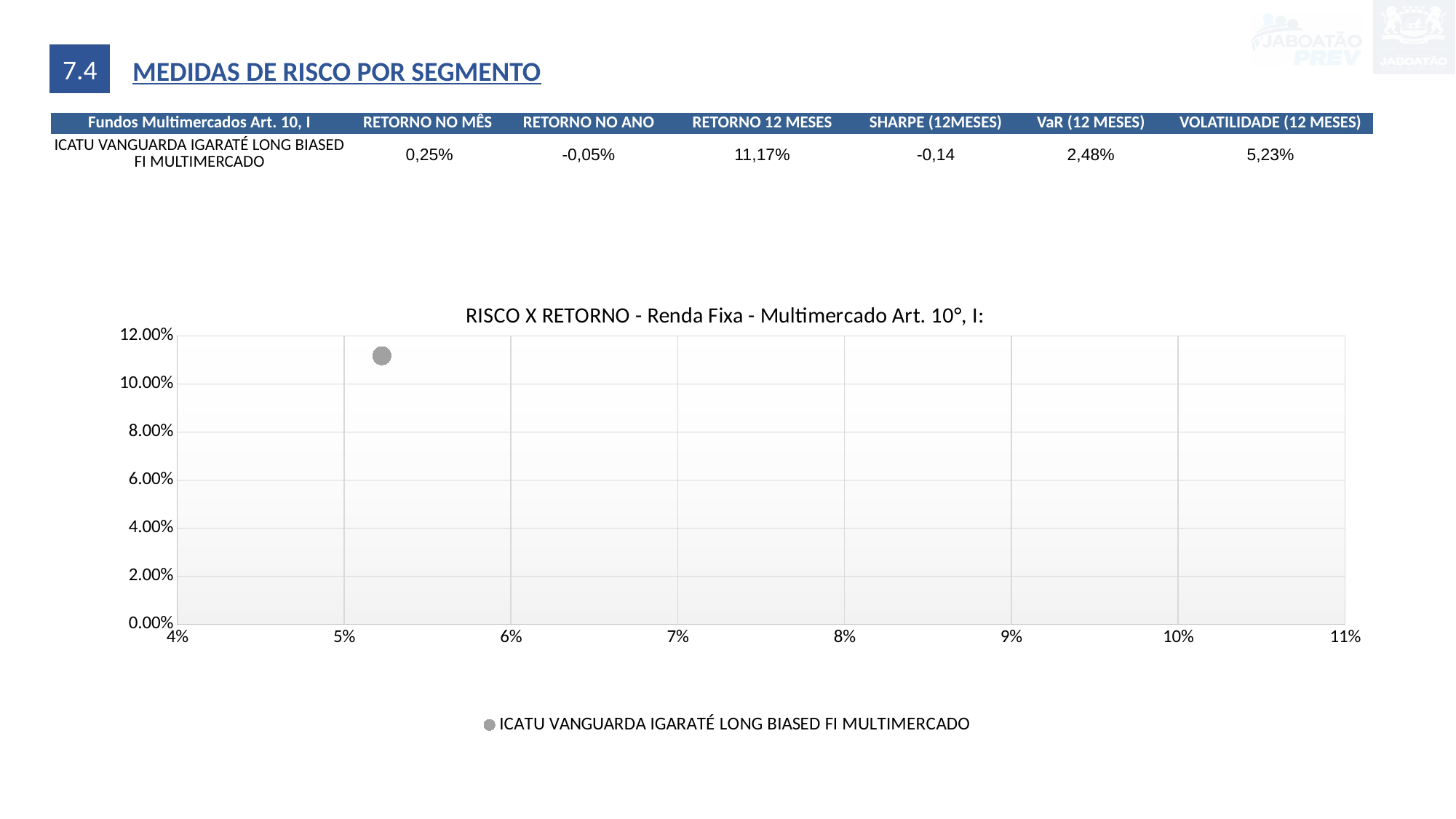
What is the title of the chart on the slide? RISCO X RETORNO - Renda Fixa - Multimercado Art. 10°, I: What is the lowest value shown on the horizontal axis of the RISCO X RETORNO chart? 4% What kind of chart is shown under the title 'RISCO X RETORNO - Renda Fixa - Multimercado Art. 10°, I:'? scatter chart In the RISCO X RETORNO chart, is the horizontal (risk) value for ICATU VANGUARDA IGARATÉ LONG BIASED FI MULTIMERCADO greater or less than 5%? greater In the RISCO X RETORNO chart, is the vertical (return) value for ICATU VANGUARDA IGARATÉ LONG BIASED FI MULTIMERCADO greater or less than 10.00%? greater How many data points are plotted in the RISCO X RETORNO chart? 1 In the RISCO X RETORNO chart, is the horizontal (risk) value for ICATU VANGUARDA IGARATÉ LONG BIASED FI MULTIMERCADO greater or less than 6%? less What is the highest value shown on the vertical axis of the RISCO X RETORNO chart? 12.00% What is the name of the series listed in the legend of the RISCO X RETORNO chart? ICATU VANGUARDA IGARATÉ LONG BIASED FI MULTIMERCADO How many series does the legend of the RISCO X RETORNO chart list? 1